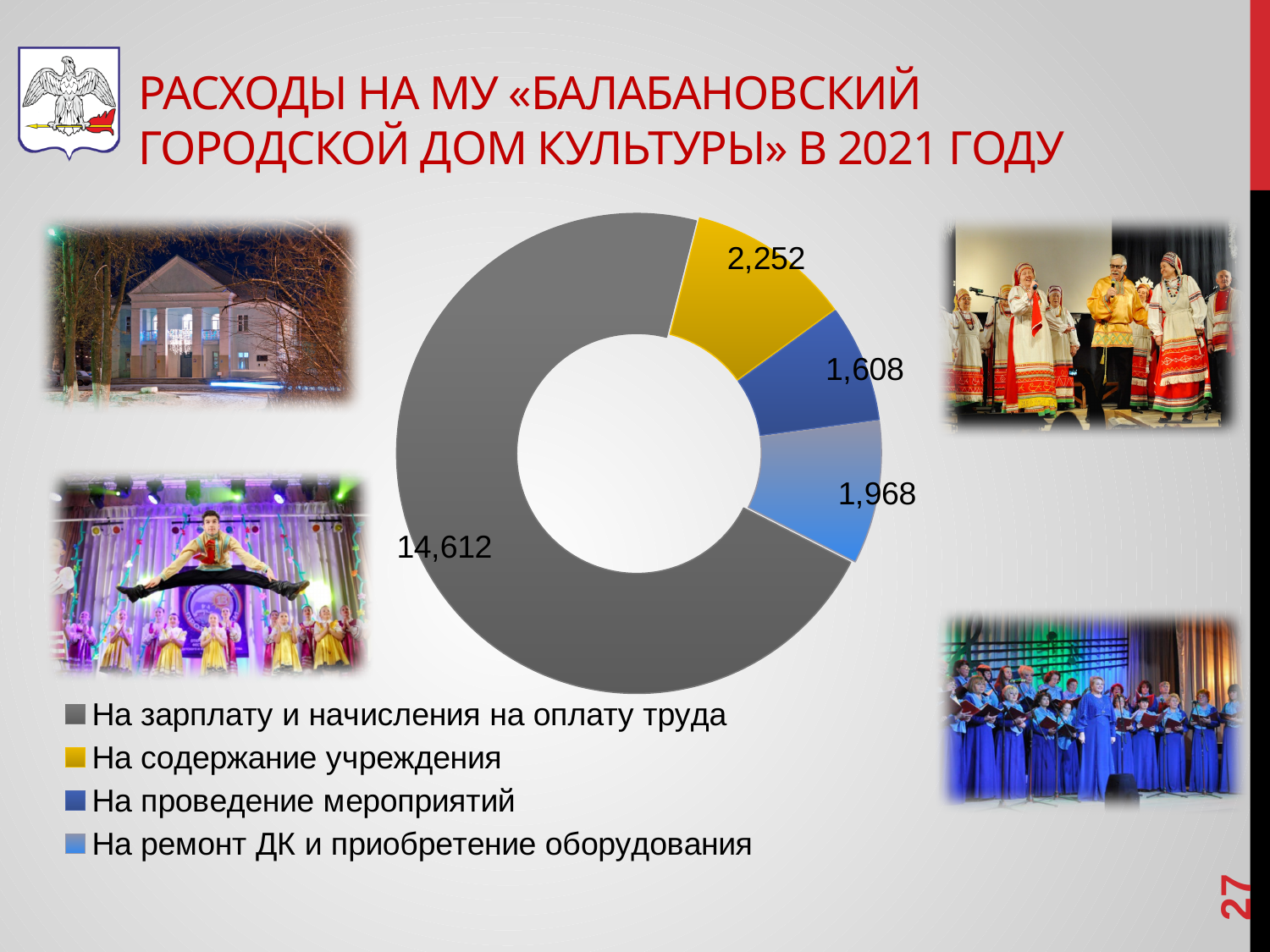
What colour is the slice for «На содержание учреждения»? Yellow Which is larger: «На ремонт ДК и приобретение оборудования» or «На проведение мероприятий»? На ремонт ДК и приобретение оборудования What kind of chart is shown on the slide? Doughnut (pie) chart What is the value for «На содержание учреждения»? 2,252 What is the total of all four values in the chart? 20,440 Which category has the largest value? На зарплату и начисления на оплату труда What is the difference between «На содержание учреждения» and «На проведение мероприятий»? 644 What is the value for «На зарплату и начисления на оплату труда»? 14,612 What is the value for «На ремонт ДК и приобретение оборудования»? 1,968 Which category has the smallest value? На проведение мероприятий How many categories does the chart show? 4 What is the value for «На проведение мероприятий»? 1,608